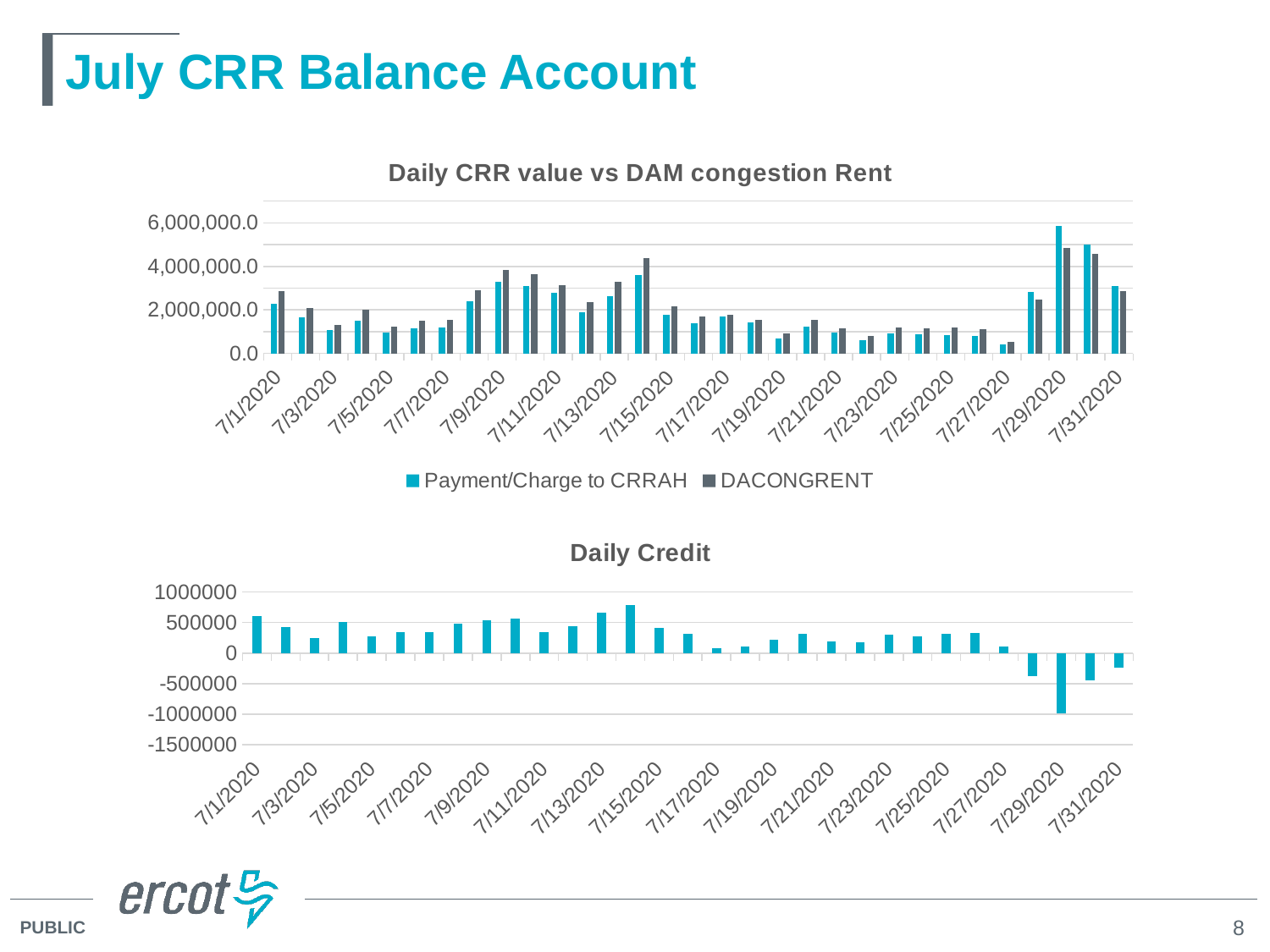
In the 'Daily Credit' chart, on which date is the value highest? 7/14/2020 What kind of chart is the 'Daily CRR value vs DAM congestion Rent' chart? bar chart In the 'Daily Credit' chart, which is larger: the value for 7/14/2020 or for 7/17/2020? 7/14/2020 In the 'Daily CRR value vs DAM congestion Rent' chart, is the Payment/Charge to CRRAH value for 7/27/2020 greater or less than 2,000,000.0? less How many series does the legend of the 'Daily CRR value vs DAM congestion Rent' chart list? 2 In the 'Daily Credit' chart, on which date is the value lowest? 7/29/2020 In the 'Daily Credit' chart, is the value for 7/29/2020 greater or less than -500000? less In the 'Daily CRR value vs DAM congestion Rent' chart, what are the two legend entries? Payment/Charge to CRRAH and DACONGRENT In the 'Daily CRR value vs DAM congestion Rent' chart, is the DACONGRENT value for 7/1/2020 greater or less than 2,000,000.0? greater In the 'Daily CRR value vs DAM congestion Rent' chart, which is larger: the Payment/Charge to CRRAH value for 7/29/2020 or for 7/27/2020? 7/29/2020 In the 'Daily CRR value vs DAM congestion Rent' chart, on which date is the Payment/Charge to CRRAH value highest? 7/29/2020